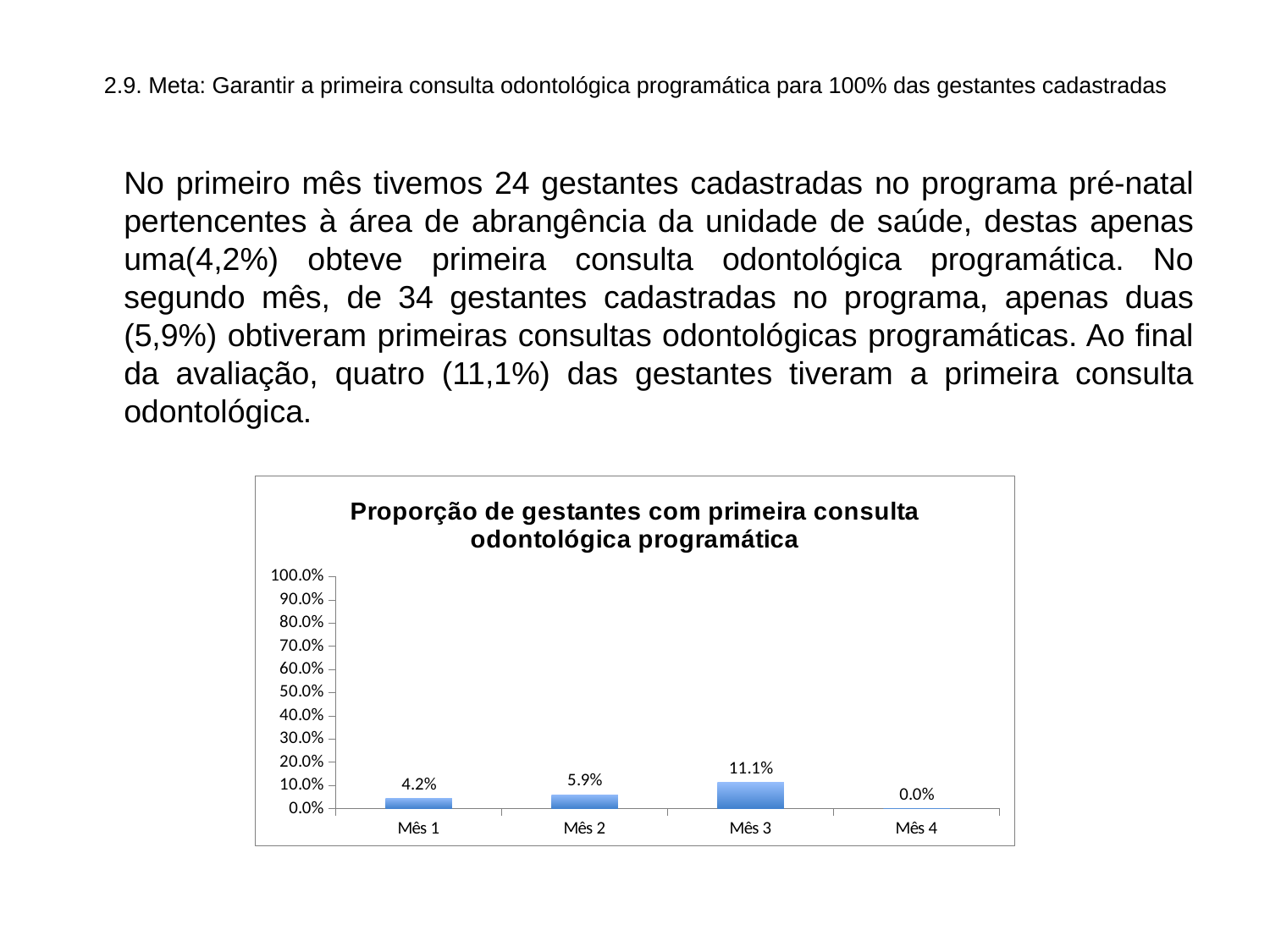
What is the value for Mês 3? 11.1% What is the value for Mês 4? 0.0% Which month has the highest value? Mês 3 What is the value for Mês 2? 5.9% What kind of chart is shown? bar chart How many months are shown on the x axis? 4 What is the value for Mês 1? 4.2% What is the difference between the values for Mês 3 and Mês 1? 6.9% What is the title of the chart? Proporção de gestantes com primeira consulta odontológica programática Which is larger, the value for Mês 2 or the value for Mês 1? Mês 2 Is the value for Mês 3 greater or less than 20.0%? less Which month has the lowest value? Mês 4